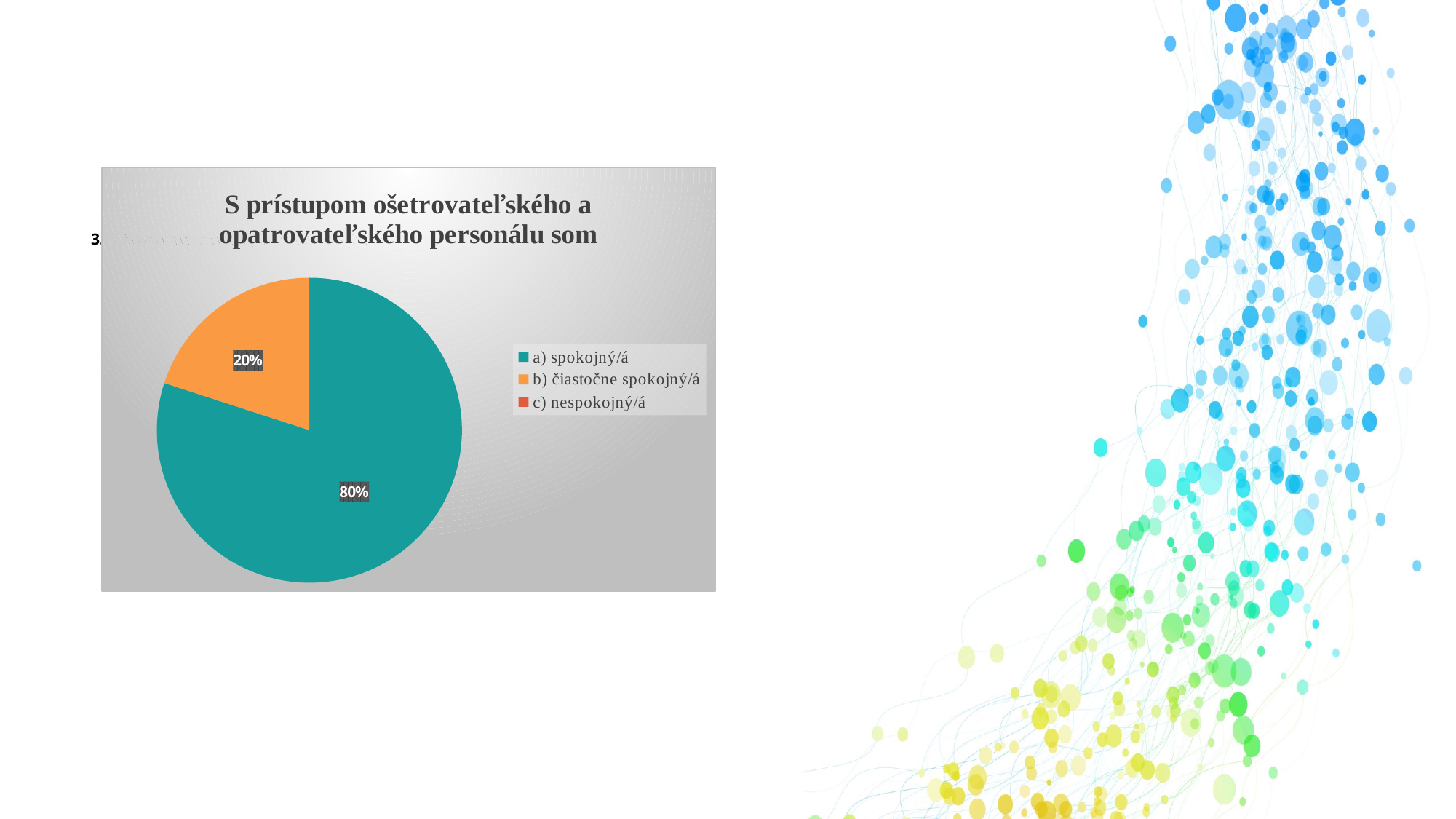
What share of the pie is labelled for "b) čiastočne spokojný/á"? 20% How many slices are visible in the pie? 2 How many entries does the legend list? 3 What share of the pie is labelled for "a) spokojný/á"? 80% What kind of chart is shown on the slide? pie chart Which is larger, the slice for "a) spokojný/á" or the slice for "b) čiastočne spokojný/á"? a) spokojný/á What is the difference in percentage points between the "a) spokojný/á" and "b) čiastočne spokojný/á" slices? 60 percentage points What colour is the slice for "b) čiastočne spokojný/á"? orange Which category has the largest slice of the pie? a) spokojný/á What is the title of the chart? S prístupom ošetrovateľského a opatrovateľského personálu som